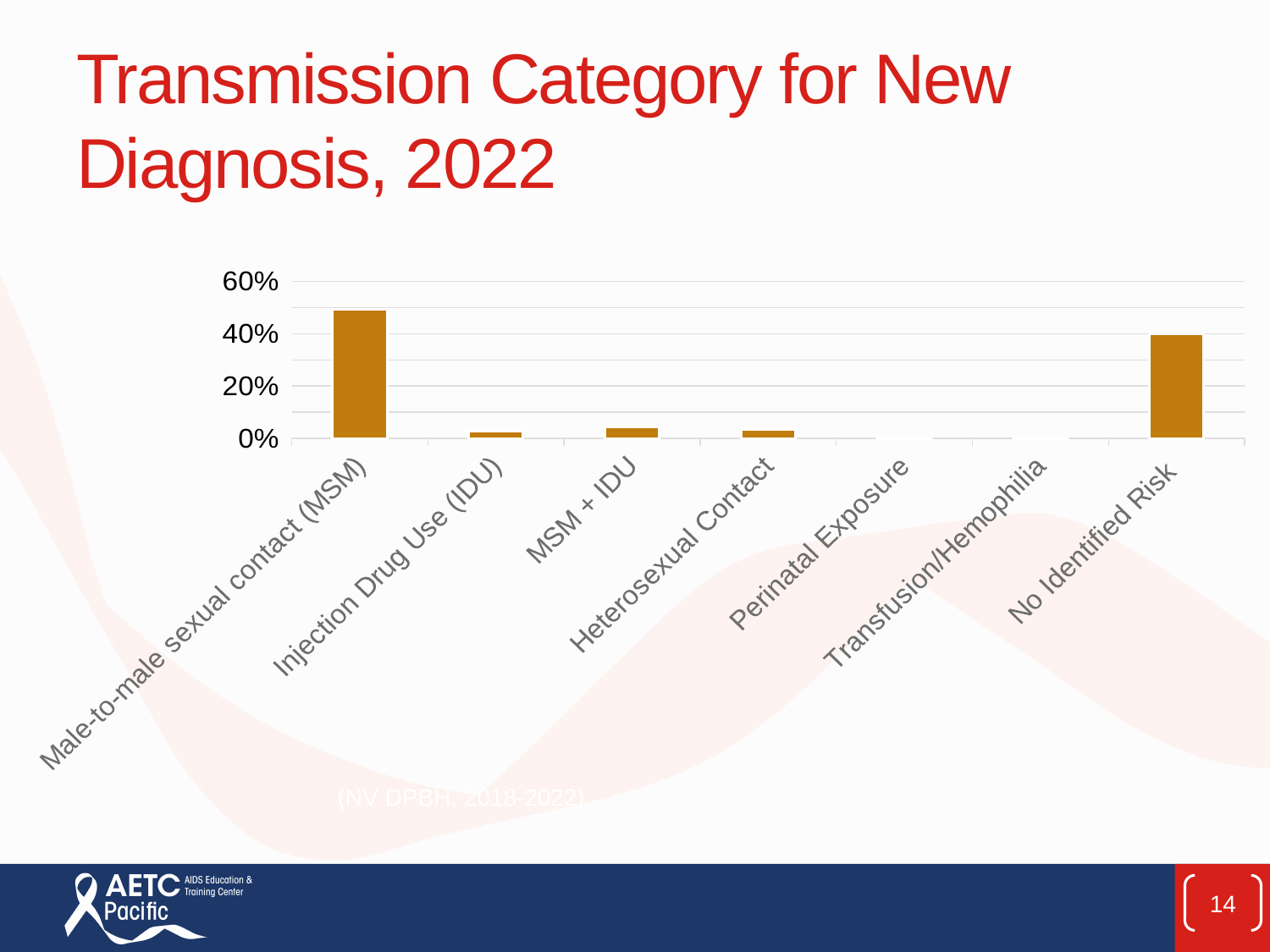
Is the value for Male-to-male sexual contact (MSM) greater or less than 40%? greater Is the value for No Identified Risk greater or less than 20%? greater What is the title of the slide containing the chart? Transmission Category for New Diagnosis, 2022 Which is larger, the value for Male-to-male sexual contact (MSM) or the value for No Identified Risk? Male-to-male sexual contact (MSM) Which is larger, the value for No Identified Risk or the value for Heterosexual Contact? No Identified Risk Is the value for Heterosexual Contact greater or less than 20%? less Which transmission category has the highest value? Male-to-male sexual contact (MSM) What kind of chart is shown on the slide? bar chart How many transmission categories are shown on the x axis? 7